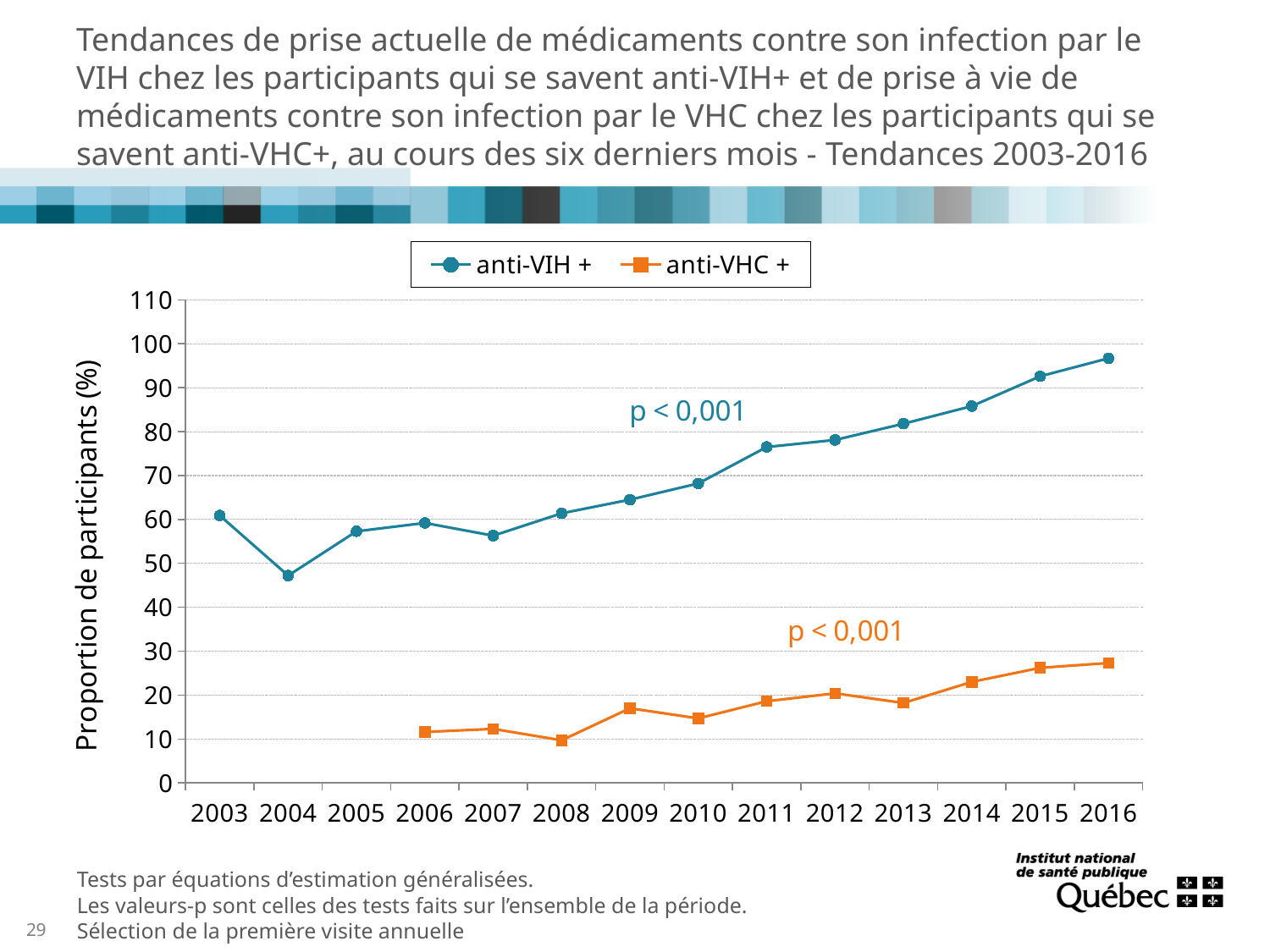
In which year is the anti-VHC + series lowest? 2008 In which year is the anti-VIH + series highest? 2016 Is the value for anti-VHC + in 2016 greater or less than 30? less How many data points does the anti-VHC + series have? 11 Is the value for anti-VIH + in 2016 greater or less than 90? greater How many years are shown on the x axis? 14 Is the value for anti-VIH + in 2004 greater or less than 50? less What kind of chart is shown on the slide? line chart What is the label of the y axis? Proportion de participants (%) How many series does the legend list? 2 In which year is the anti-VIH + series lowest? 2004 Which is larger for the anti-VIH + series: the value in 2010 or the value in 2011? 2011